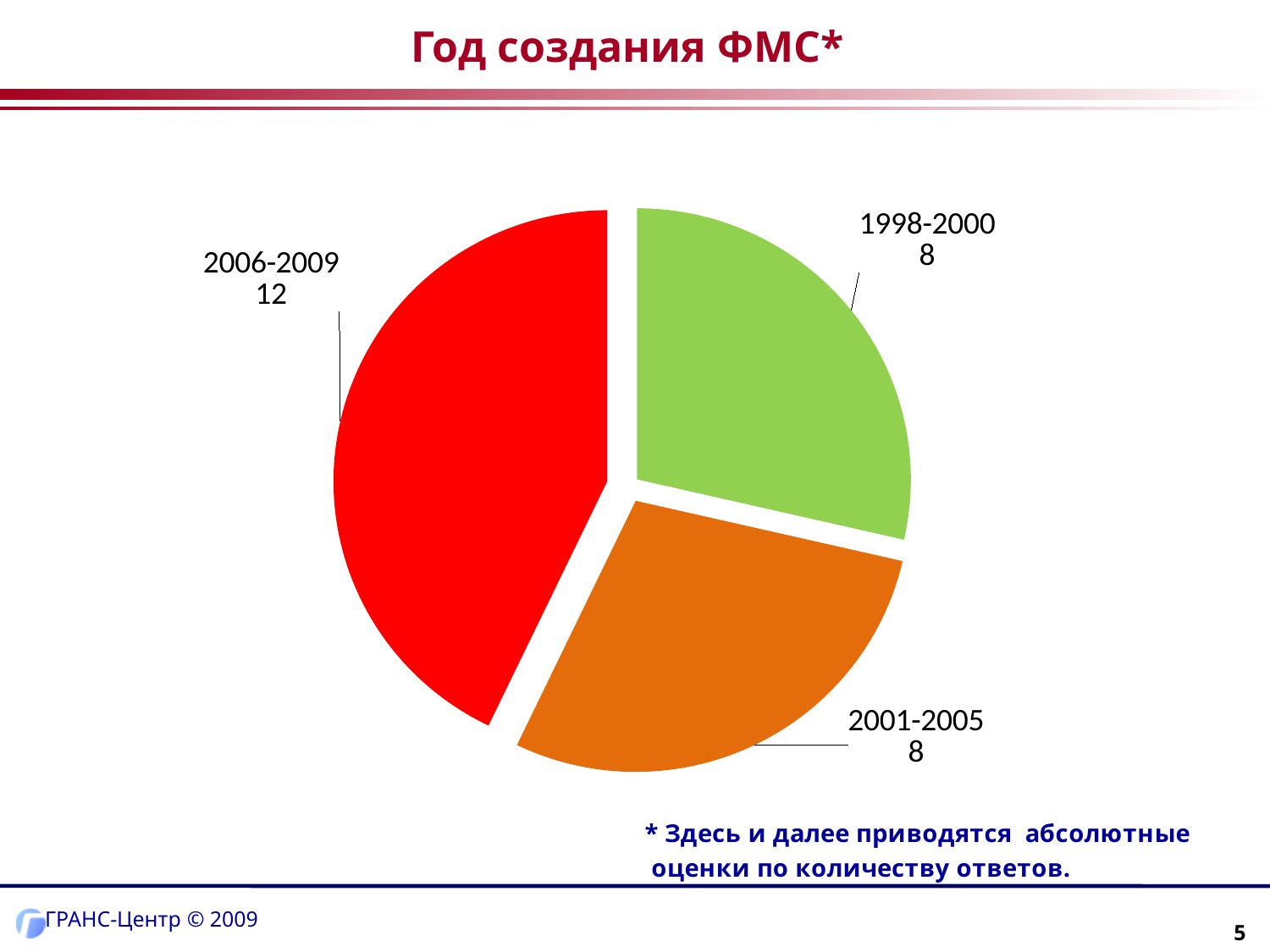
Which category has the largest value in the pie chart? 2006-2009 What colour is the slice for 2006-2009? Red What is the value for the 1998-2000 category? 8 How many categories (slices) does the pie chart have? 3 What is the difference between the values for 2006-2009 and 2001-2005? 4 What is the value for the 2001-2005 category? 8 What is the total of all the values shown in the pie chart? 28 Which is larger, the value for 1998-2000 or the value for 2001-2005? They are equal (both 8) What is the title of the chart? Год создания ФМС* What fraction of the total do the 2006-2009 responses represent? 12/28 What is the value for the 2006-2009 category? 12 What type of chart is shown on the slide? Pie chart